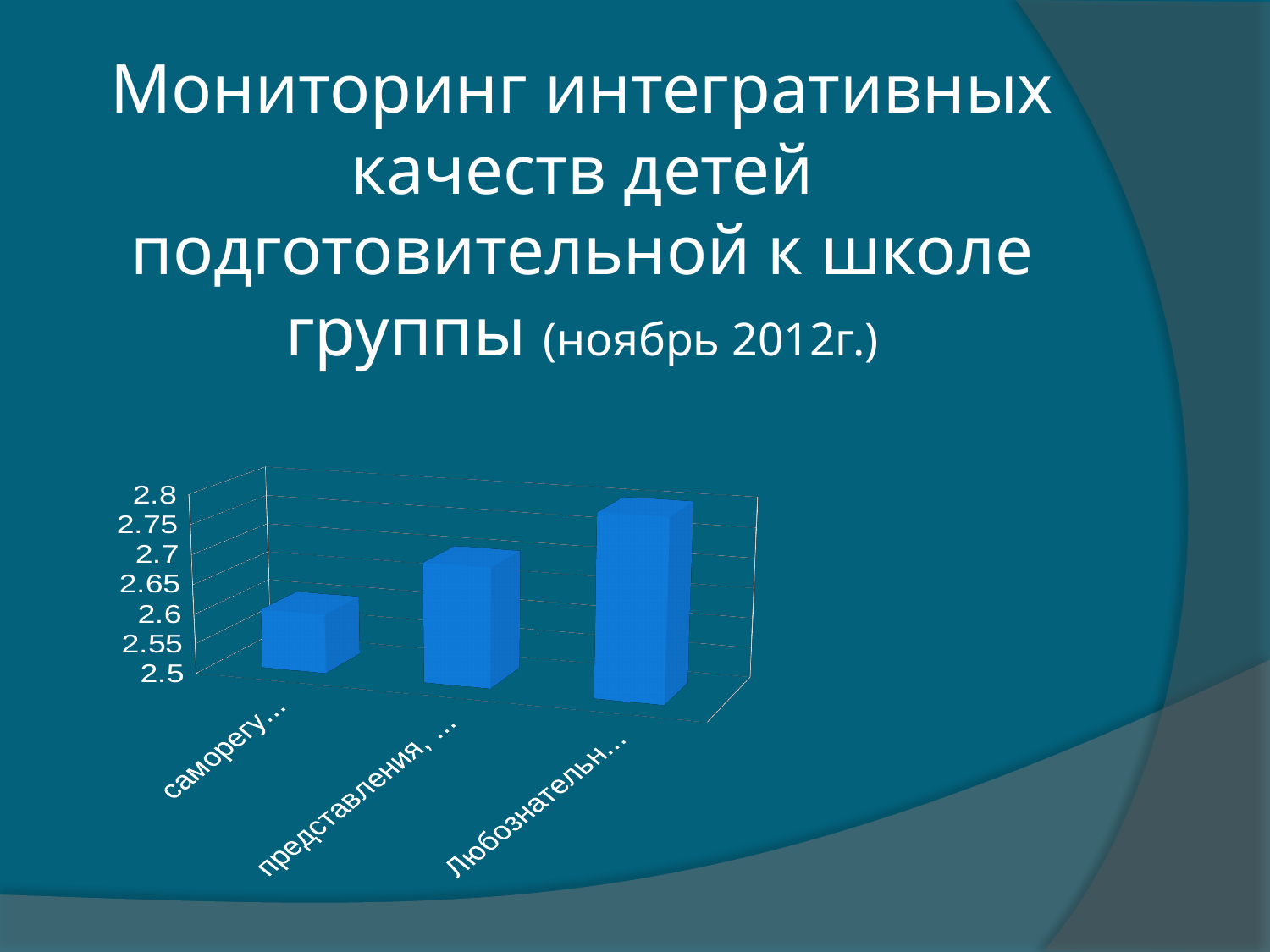
How many bars (categories) does the chart show? 3 Which category has the highest bar? Любознательн… Which category has the lowest bar? саморегу… Do the bar values rise or fall from left to right along the x axis? rise Is the value for "представления, …" greater or less than 2.6? greater Is the value for "Любознательн…" greater or less than 2.7? greater What is the lowest value shown on the vertical axis? 2.5 What colour are the bars in the chart? blue Which is larger, the value for "представления, …" or the value for "саморегу…"? представления, … What kind of chart is shown on the slide? bar chart Is the value for "саморегу…" greater or less than 2.7? less Which is larger, the value for "Любознательн…" or the value for "представления, …"? Любознательн…